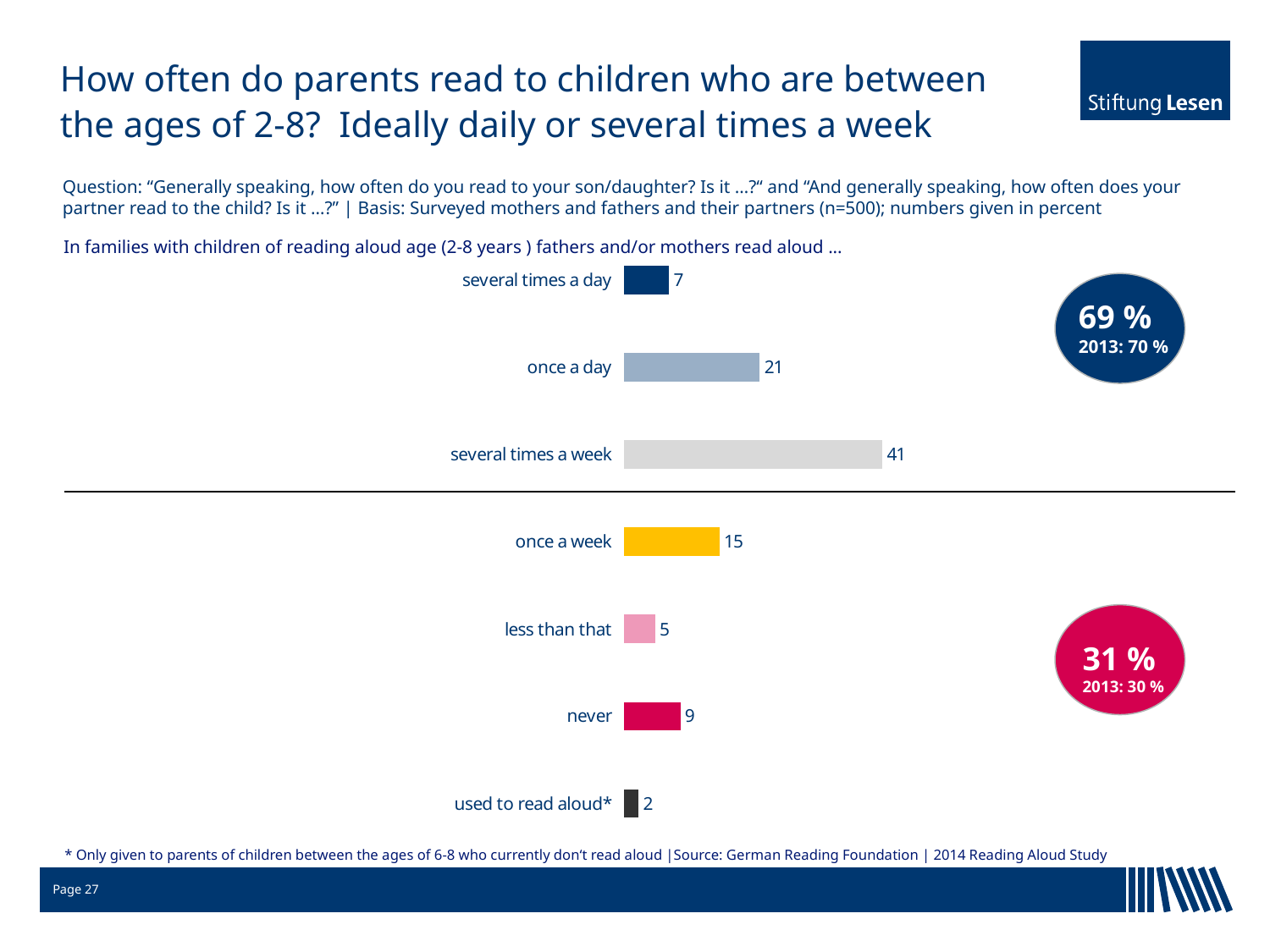
What was the 2013 value shown in the red circle? 30 % Which category has the highest value? several times a week What is the value for "used to read aloud*"? 2 What percentage is shown in the blue circle on the right of the chart? 69 % Which category has the lowest value? used to read aloud* What is the value for "never"? 9 Which is larger, the value for "once a week" or the value for "never"? once a week How many categories are shown in the chart? 7 What is the value for "once a day"? 21 What is the difference between the values for "several times a week" and "once a day"? 20 What kind of chart is shown on the slide? bar chart What is the value for "several times a week"? 41